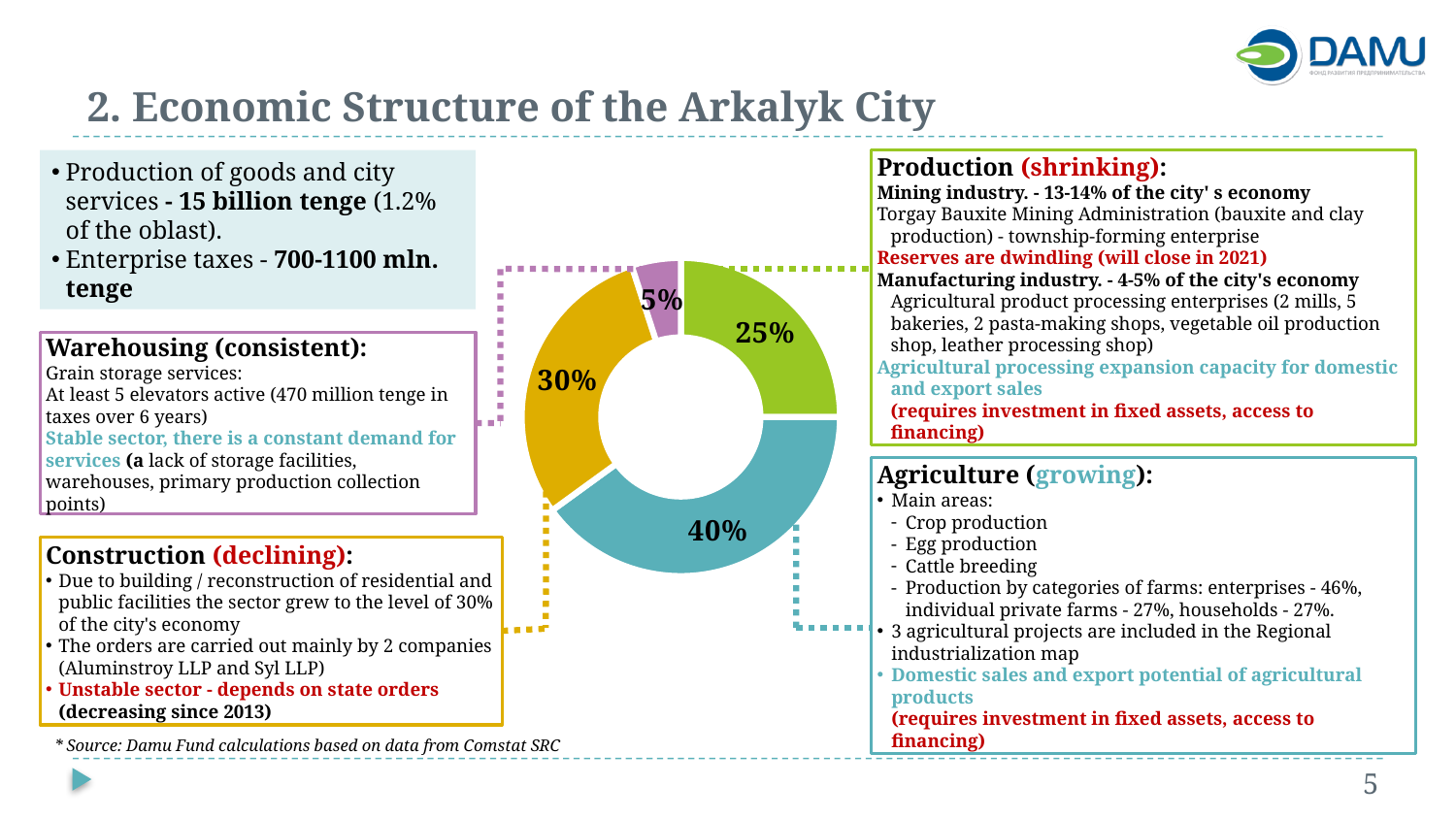
What is the smallest share shown in the donut chart? 5% Which sector box is connected by a dotted line to the 40% slice of the donut chart? Agriculture How many slices does the donut chart have? 4 Which sector box is connected by a dotted line to the 30% slice of the donut chart? Construction What share is shown for the teal slice of the donut chart? 40% What is the difference between the largest and smallest slices of the donut chart? 35 percentage points What is the largest share shown in the donut chart? 40% What share is shown for the yellow slice of the donut chart? 30% What share is shown for the green slice of the donut chart? 25% What share is shown for the purple slice of the donut chart? 5% What kind of chart is shown in the centre of the slide? Pie chart (donut) Which is larger in the donut chart: the green slice or the yellow slice? The yellow slice (30%)